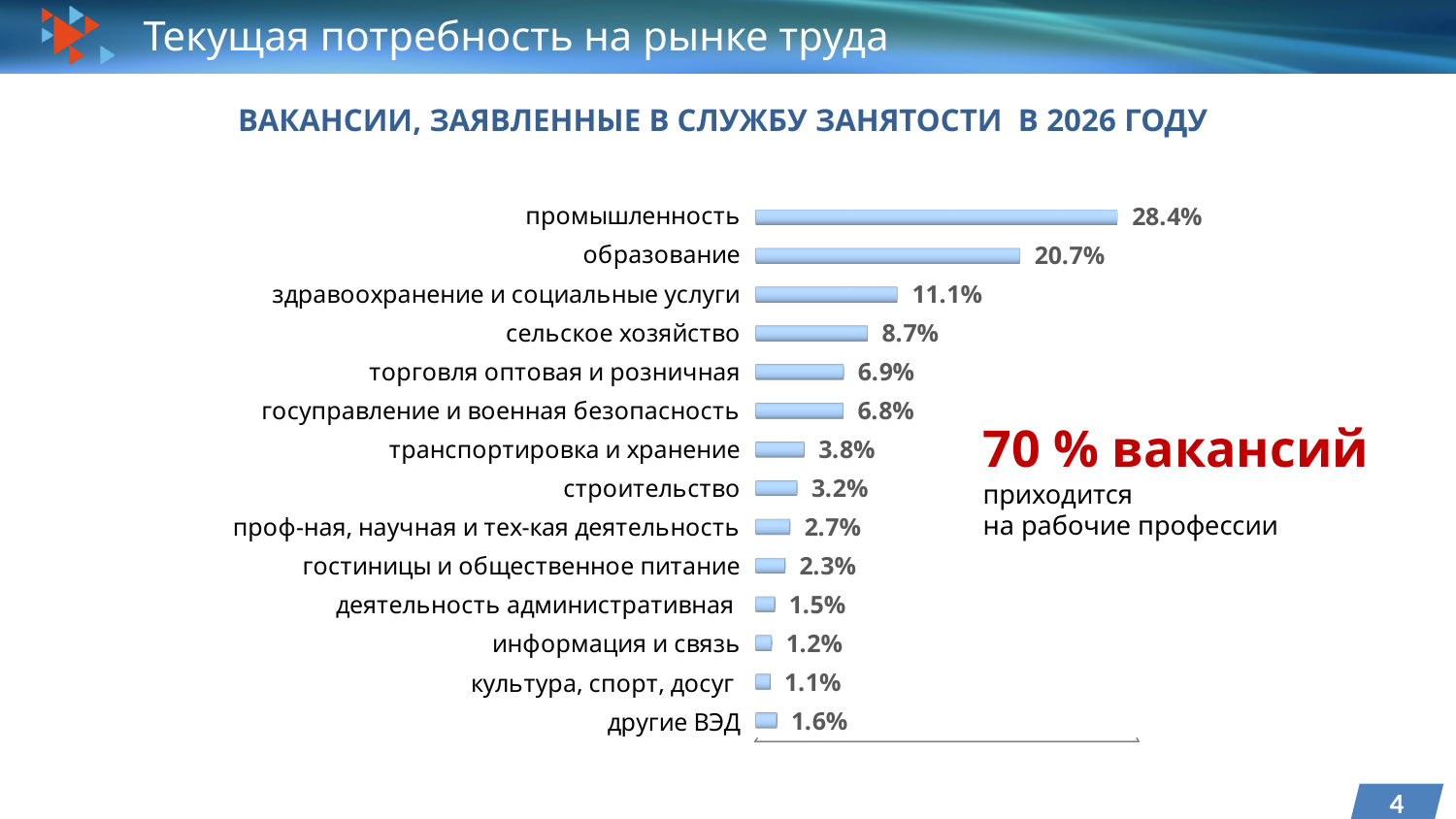
What is the value for образование? 20.7% Which is larger, the value for сельское хозяйство or the value for здравоохранение и социальные услуги? здравоохранение и социальные услуги What is the difference between the values for торговля оптовая и розничная and госуправление и военная безопасность? 0.1% What is the difference between the values for промышленность and образование? 7.7% What is the value for промышленность? 28.4% How many categories are shown in the chart? 14 What is the value for другие ВЭД? 1.6% Which category has the highest value? промышленность What is the title of the chart? ВАКАНСИИ, ЗАЯВЛЕННЫЕ В СЛУЖБУ ЗАНЯТОСТИ В 2026 ГОДУ Which category has the lowest value? культура, спорт, досуг What is the value for транспортировка и хранение? 3.8% What kind of chart is shown on the slide? bar chart